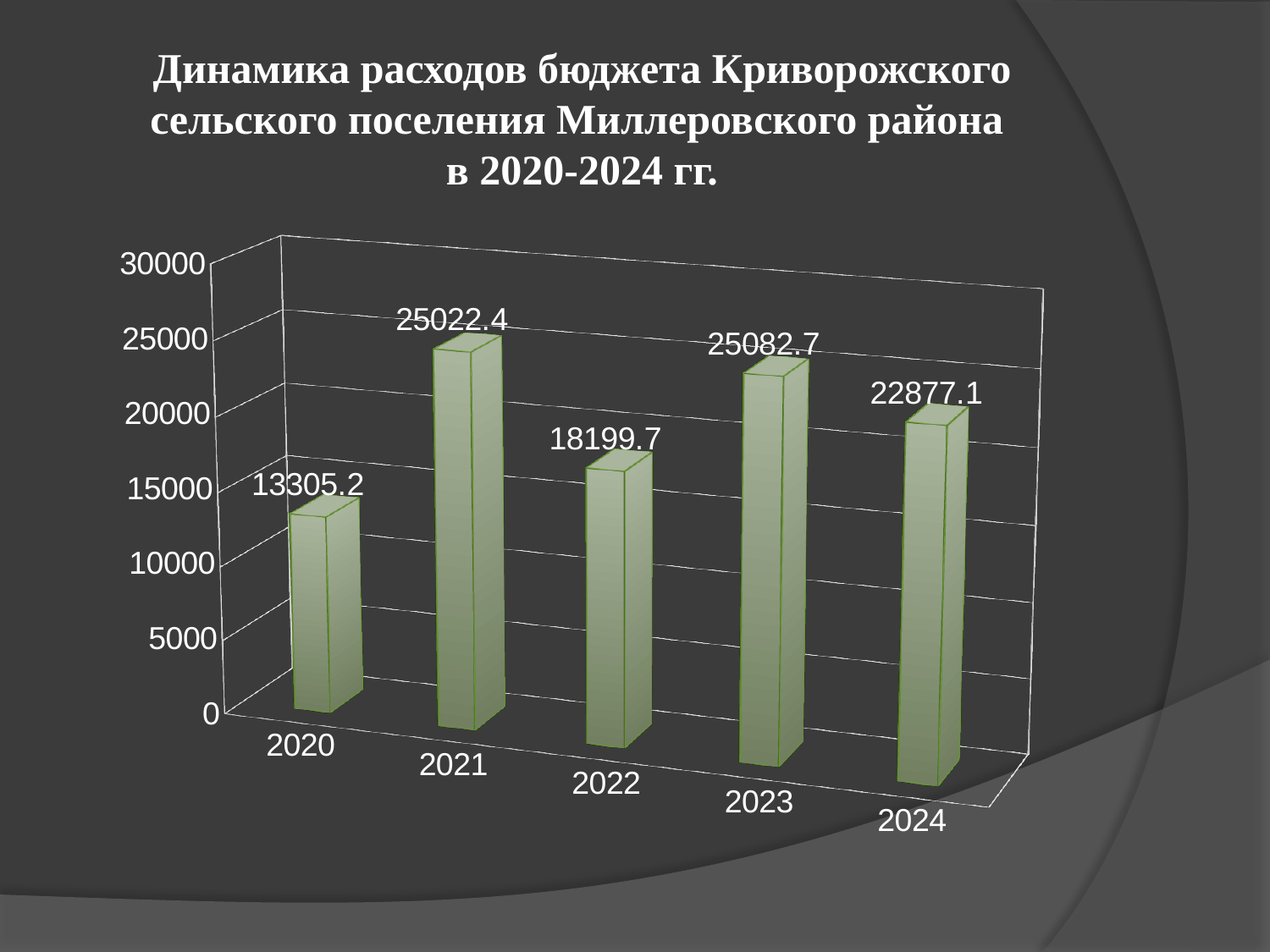
What is the difference between the values for 2021 and 2020? 11717.2 Which year has the lowest value? 2020 Is the value for 2021 greater or less than 20000? greater What is the value for 2020? 13305.2 How many years are shown on the chart? 5 What kind of chart is shown on the slide? bar chart What is the value for 2022? 18199.7 Which is larger, the value for 2022 or the value for 2024? 2024 Which year has the highest value? 2023 What is the highest value shown on the vertical axis? 30000 What is the value for 2024? 22877.1 What is the difference between the values for 2023 and 2024? 2205.6